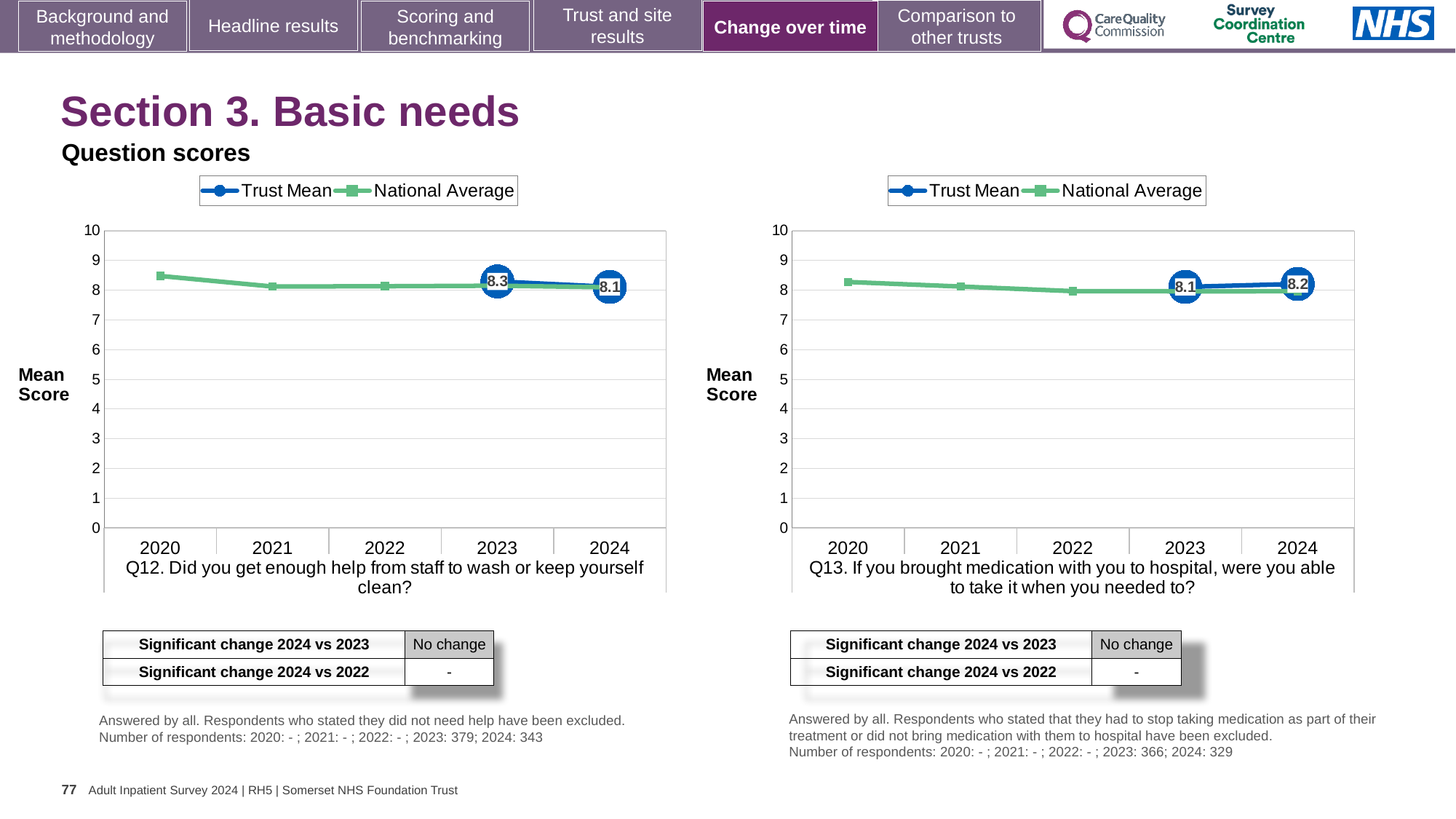
What type of chart is used for Q13 on the right? Line chart How many series does the legend of the Q12 chart on the left list? 2 How many years are shown on the x axis of the Q13 chart on the right? 5 In the Q13 chart on the right, what is the Trust Mean for 2024? 8.2 In the Q13 chart on the right, what is the difference between the Trust Mean for 2024 and 2023? 0.1 In the Q12 chart on the left, what is the Trust Mean for 2024? 8.1 In the Q13 chart on the right, does the Trust Mean rise or fall from 2023 to 2024? rise In the Q12 chart on the left, which year has the higher Trust Mean, 2023 or 2024? 2023 In the Q12 chart on the left, what is the Trust Mean for 2023? 8.3 In the Q13 chart on the right, what is the Trust Mean for 2023? 8.1 In the Q12 chart on the left, by how much did the Trust Mean change from 2023 to 2024? 0.2 In the Q12 chart on the left, is the National Average for 2020 greater or less than 8? greater